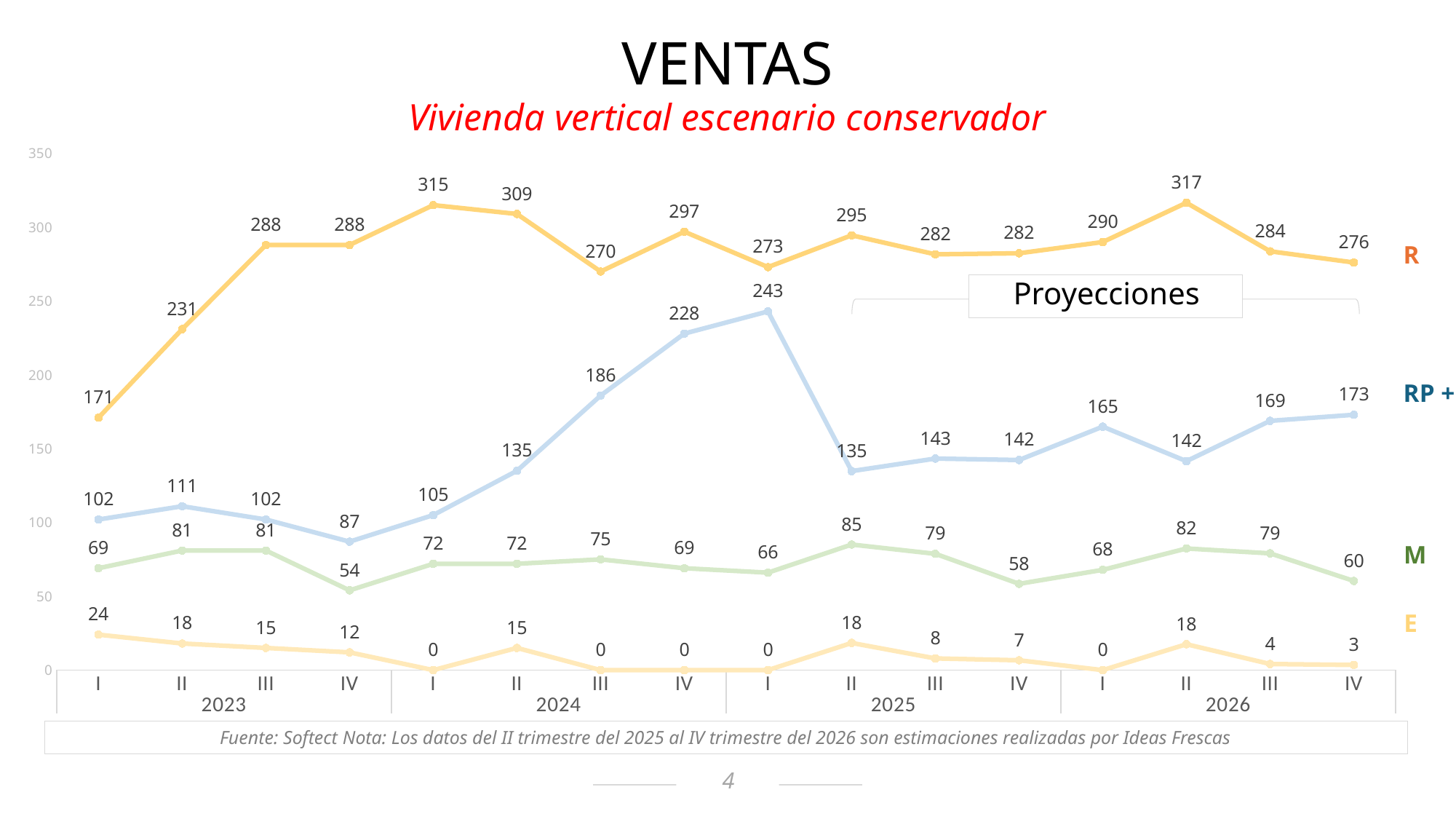
What is the value of the E series in quarter IV of 2026? 3 How many quarters (data points) are plotted along the x axis? 16 In which quarter does the M series reach its lowest value? IV 2023 How many series are shown in the chart? 4 What is the value of the RP + series in quarter I of 2025? 243 Does the R series rise or fall from quarter I of 2023 to quarter I of 2024? Rise What is the value of the M series in quarter II of 2025? 85 What is the difference between the R value and the RP + value in quarter I of 2024? 210 What is the value of the R series in quarter I of 2023? 171 In which quarter does the R series reach its highest value? II 2026 What type of chart is shown on the slide? Line chart Which is larger in quarter IV of 2024: the RP + value or the M value? RP +